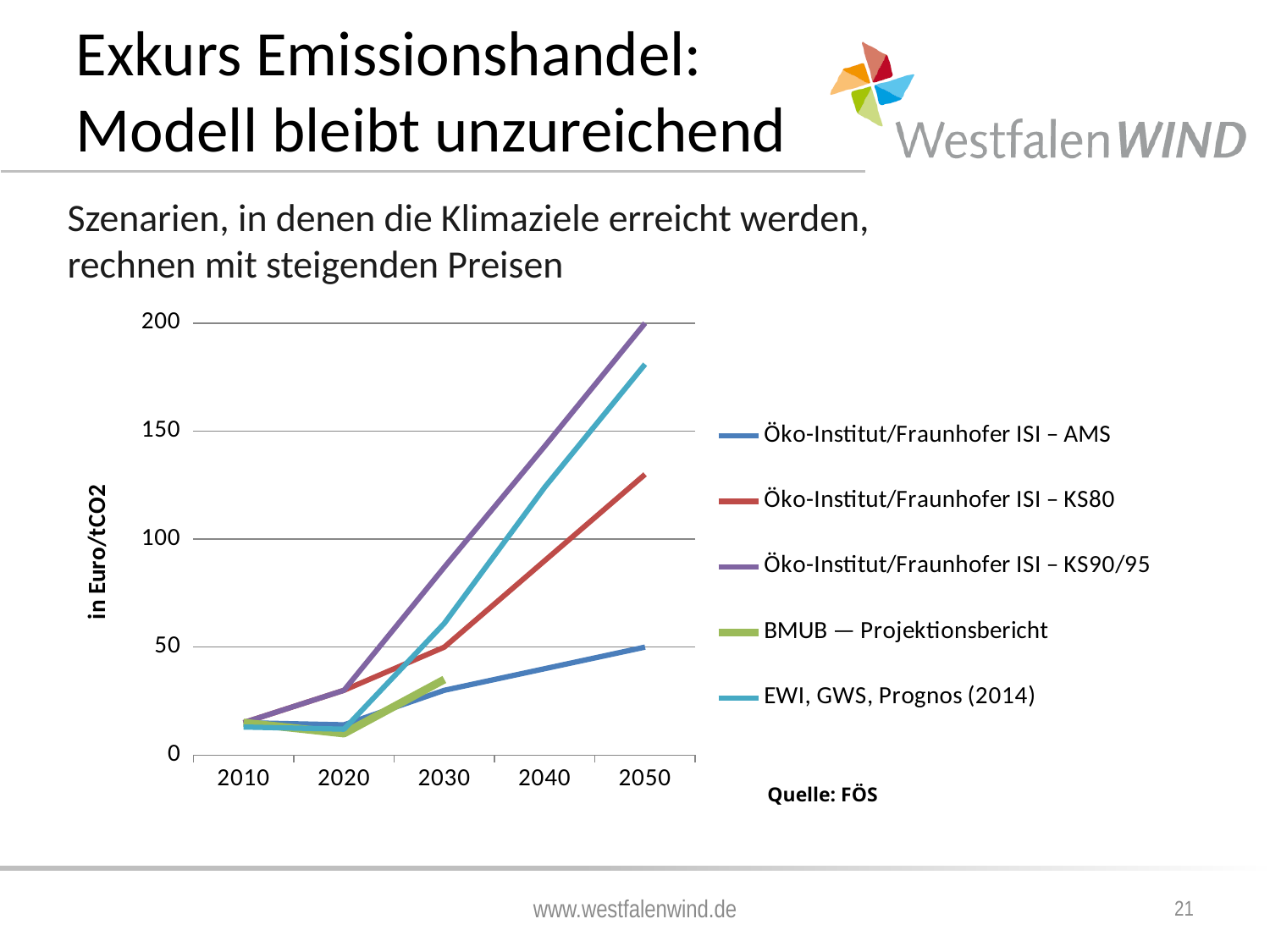
Is the value for Öko-Institut/Fraunhofer ISI – KS80 in 2050 greater or less than 100? greater Is the value for EWI, GWS, Prognos (2014) in 2050 greater or less than 150? greater How many series does the legend list? 5 In 2050, which is larger: EWI, GWS, Prognos (2014) or Öko-Institut/Fraunhofer ISI – KS80? EWI, GWS, Prognos (2014) How many year labels are shown on the x axis? 5 Does the Öko-Institut/Fraunhofer ISI – KS90/95 series rise or fall from 2010 to 2050? rise Which series has the highest value in 2050? Öko-Institut/Fraunhofer ISI – KS90/95 Which series has the lowest value in 2050? Öko-Institut/Fraunhofer ISI – AMS Is the value for BMUB — Projektionsbericht in 2030 greater or less than 50? less What kind of chart is shown on the slide? line chart What is the label on the y axis of the chart? in Euro/tCO2